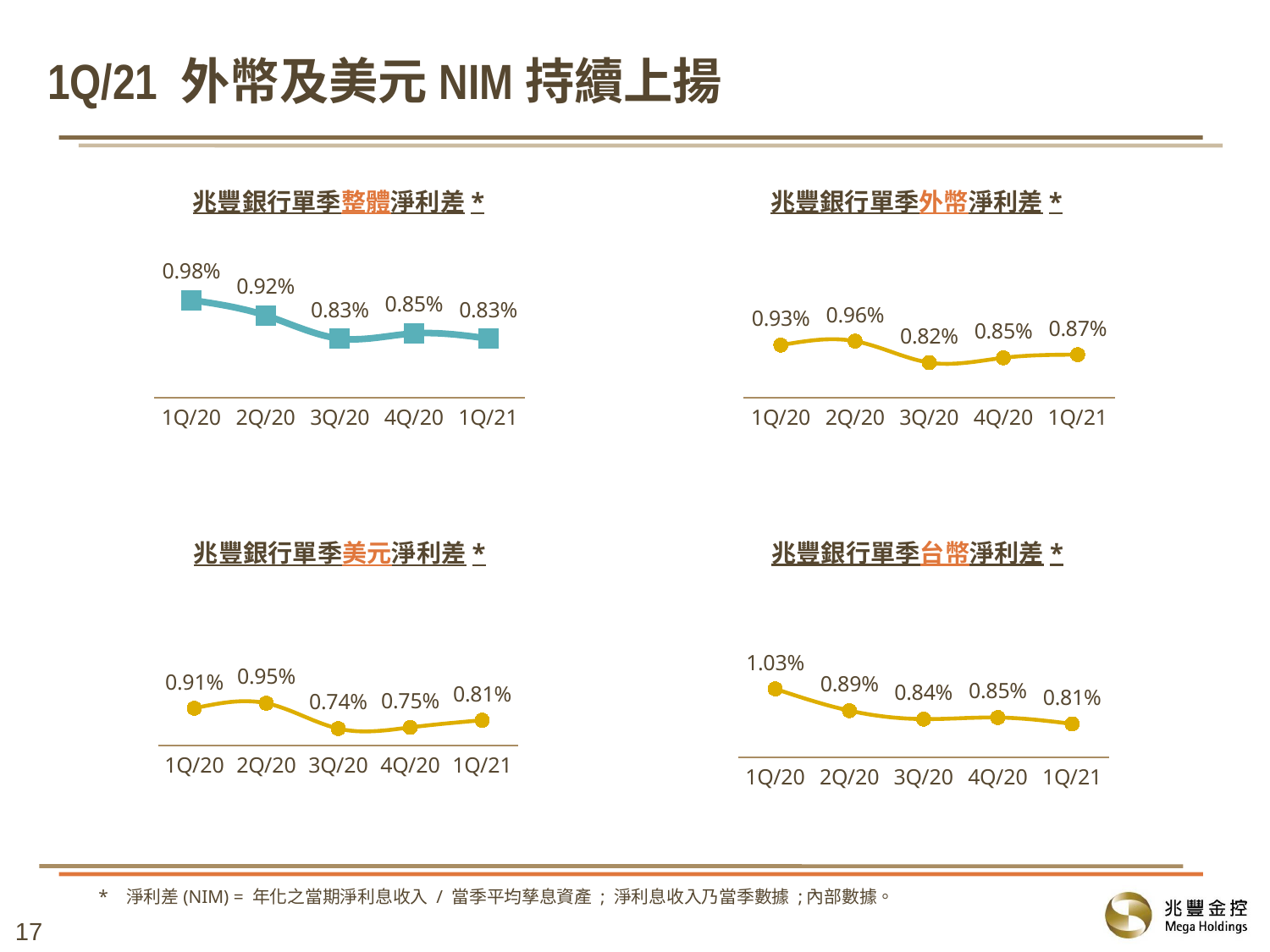
In the bottom-left chart (兆豐銀行單季美元淨利差), what is the value for 3Q/20? 0.74% In the top-right chart (兆豐銀行單季外幣淨利差), what is the difference between the 1Q/21 value and the 1Q/20 value? -0.06% In the bottom-right chart (兆豐銀行單季台幣淨利差), which quarter has the highest value? 1Q/20 In the bottom-left chart (兆豐銀行單季美元淨利差), what is the difference between the 2Q/20 value and the 3Q/20 value? 0.21% How many charts are shown on the slide? 4 In the top-right chart (兆豐銀行單季外幣淨利差), what is the value for 1Q/21? 0.87% How many data points are plotted in the bottom-right chart (兆豐銀行單季台幣淨利差)? 5 In the bottom-right chart (兆豐銀行單季台幣淨利差), do the values generally rise or fall from 1Q/20 to 1Q/21? Fall In the top-left chart (兆豐銀行單季整體淨利差), what is the value for 1Q/20? 0.98% In the top-left chart (兆豐銀行單季整體淨利差), which is larger, the value for 2Q/20 or the value for 4Q/20? 2Q/20 In the top-right chart (兆豐銀行單季外幣淨利差), which quarter has the lowest value? 3Q/20 What kind of chart is the top-left chart (兆豐銀行單季整體淨利差)? Line chart